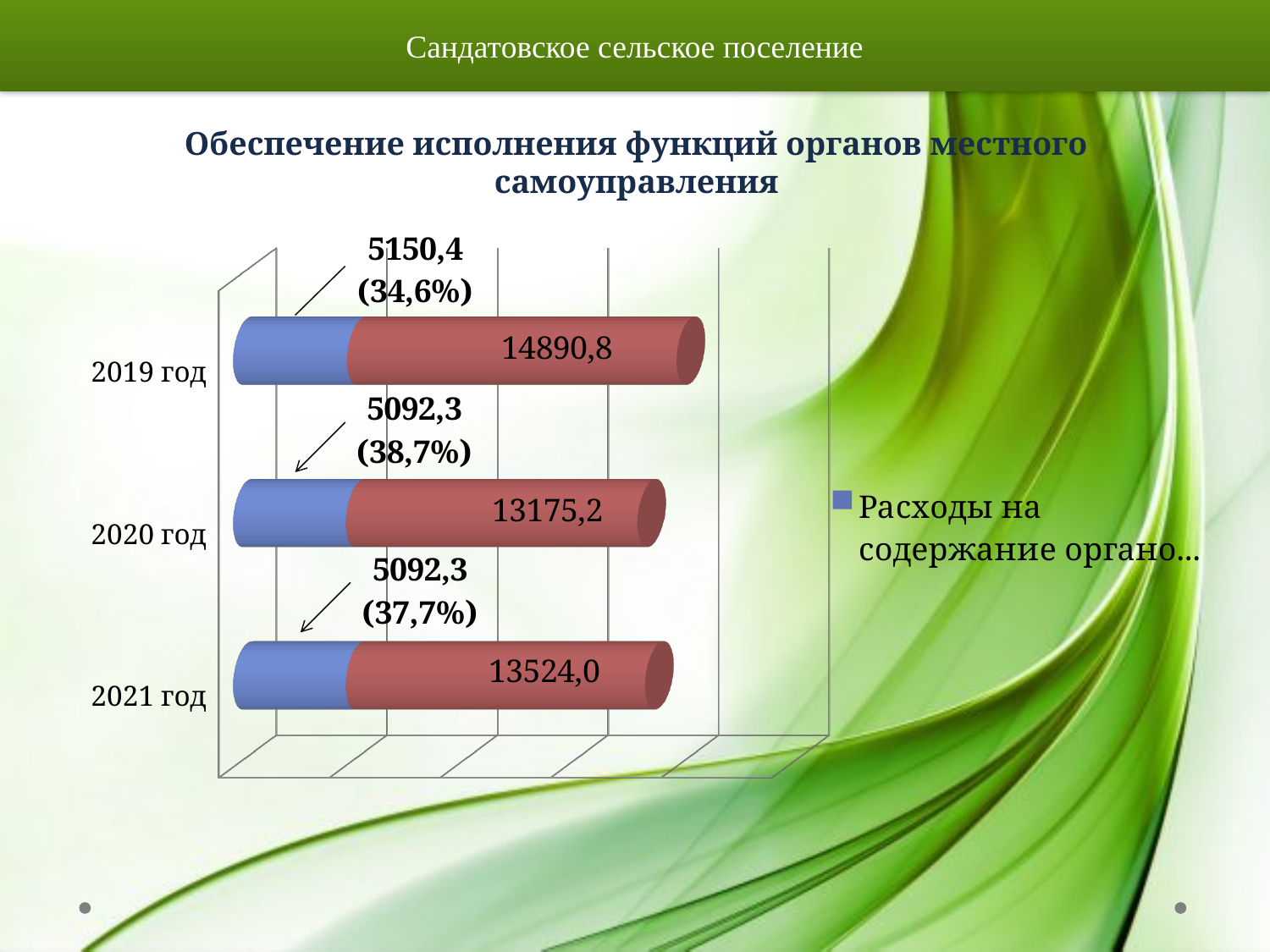
What is the title of the chart? Обеспечение исполнения функций органов местного самоуправления What percentage is shown next to the blue segment for 2021 год? 37,7% What is the value of the red segment for 2021 год? 13524,0 Which year has the highest red segment value? 2019 год What is the difference between the red segment values for 2019 год and 2020 год? 1715,6 What is the value of the red segment for 2020 год? 13175,2 What kind of chart is shown on the slide? Bar chart How many years are shown on the chart? 3 Which is larger, the red segment value for 2020 год or for 2021 год? 2021 год Which year has the lowest red segment value? 2020 год What is the difference between the blue segment values for 2019 год and 2020 год? 58,1 What is the value of the blue segment for 2019 год? 5150,4